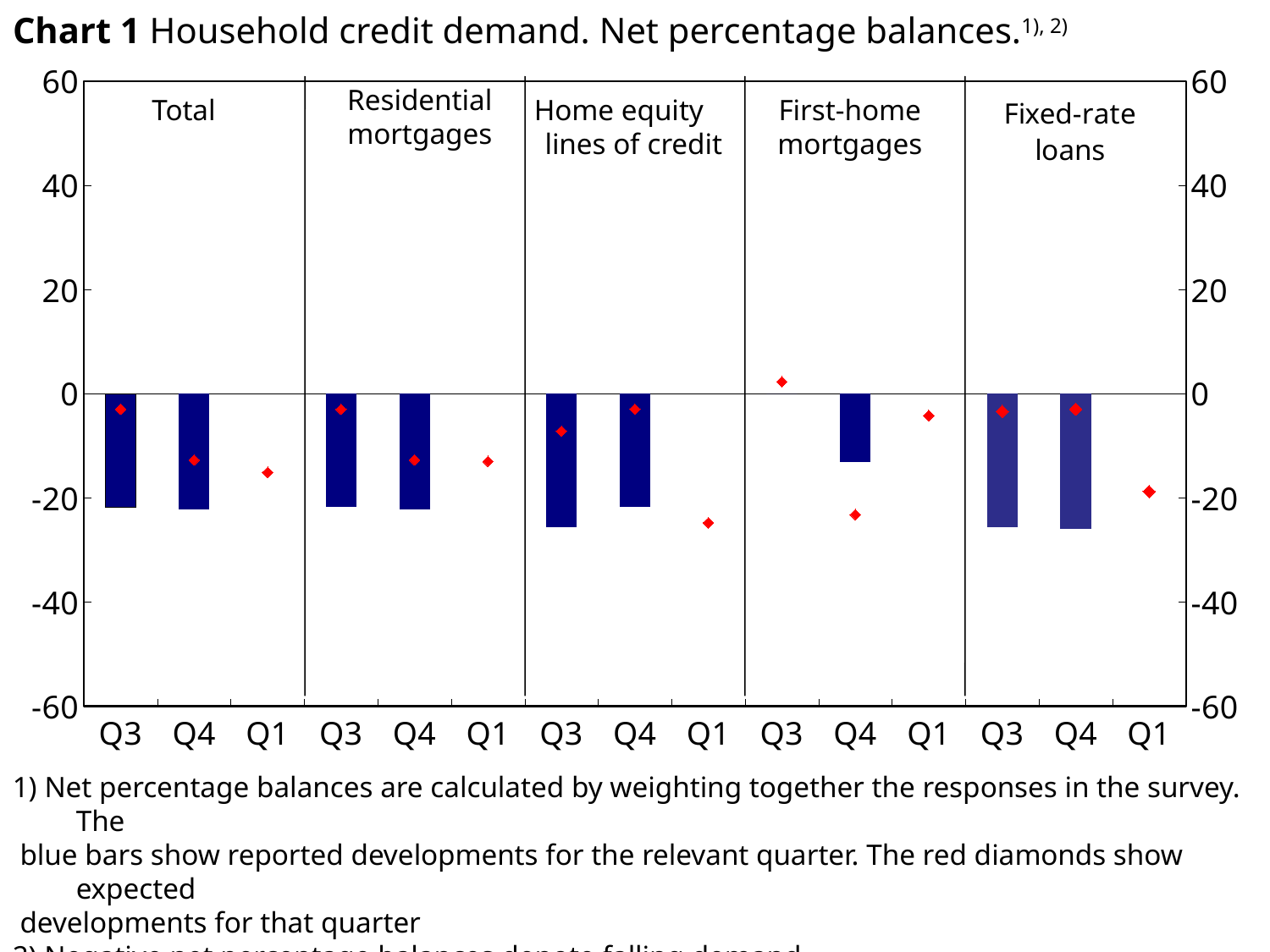
Is the Q3 red diamond for First-home mortgages greater or less than 0? greater How many credit categories (panels) does Chart 1 show? 5 According to the footnote, what do the red diamonds show? Expected developments for that quarter Which category and quarter has the only red diamond above zero? First-home mortgages, Q3 Which is higher: the Q4 bar for First-home mortgages or the Q4 bar for Total? First-home mortgages Is the Q1 red diamond for Home equity lines of credit greater or less than -20? less What kind of chart is Chart 1? bar chart How many quarters are shown on the x axis within each panel of Chart 1? 3 Which is lower: the Q3 bar for Home equity lines of credit or the Q3 bar for Residential mortgages? Home equity lines of credit How many blue bars are shown in the First-home mortgages panel? 1 Is the Q4 bar for First-home mortgages greater or less than -20? greater